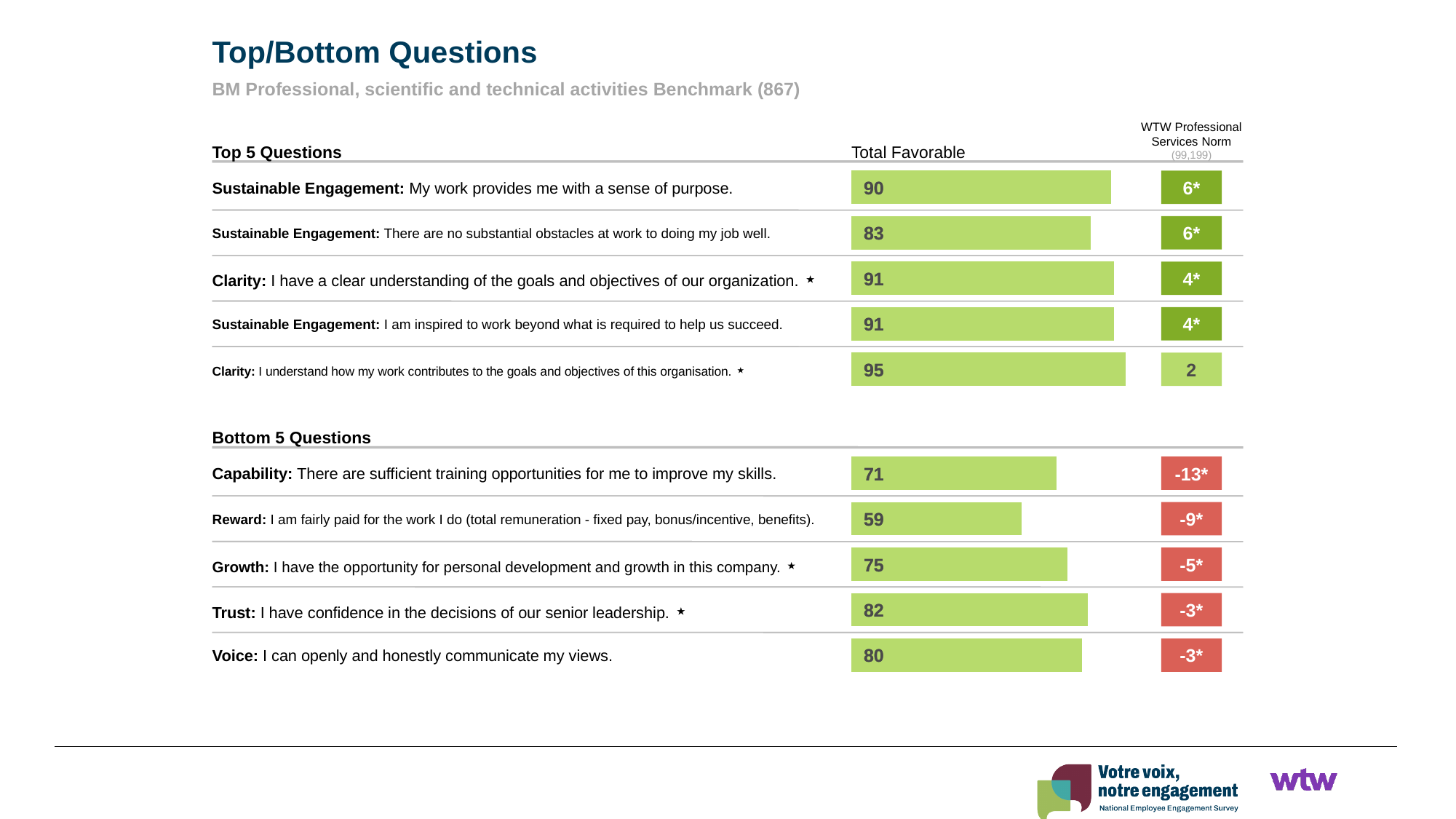
In the Top 5 Questions chart, what is the Total Favorable value for "Sustainable Engagement: My work provides me with a sense of purpose"? 90 In the Top 5 Questions chart, which has a higher Total Favorable: "Sustainable Engagement: My work provides me with a sense of purpose" or "Sustainable Engagement: There are no substantial obstacles at work to doing my job well"? Sustainable Engagement: My work provides me with a sense of purpose. In the Bottom 5 Questions chart, what is the WTW Professional Services Norm difference shown for "Capability: There are sufficient training opportunities for me to improve my skills"? -13* What is the benchmark named in the subtitle of the slide? BM Professional, scientific and technical activities Benchmark (867) In the Top 5 Questions chart, what is the WTW Professional Services Norm difference for "Clarity: I have a clear understanding of the goals and objectives of our organization"? 4* In the Top 5 Questions chart, what is the Total Favorable value for "Clarity: I understand how my work contributes to the goals and objectives of this organisation"? 95 In the Bottom 5 Questions chart, which question has the lowest Total Favorable value? Reward: I am fairly paid for the work I do (total remuneration - fixed pay, bonus/incentive, benefits). What kind of chart is used to show the Total Favorable values on this slide? Bar chart In the Bottom 5 Questions chart, what is the Total Favorable value for "Reward: I am fairly paid for the work I do"? 59 In the Bottom 5 Questions chart, what is the difference in Total Favorable between "Trust: I have confidence in the decisions of our senior leadership" and "Voice: I can openly and honestly communicate my views"? 2 In the Top 5 Questions chart, which question has the highest Total Favorable value? Clarity: I understand how my work contributes to the goals and objectives of this organisation. How many questions are listed in the Bottom 5 Questions chart? 5